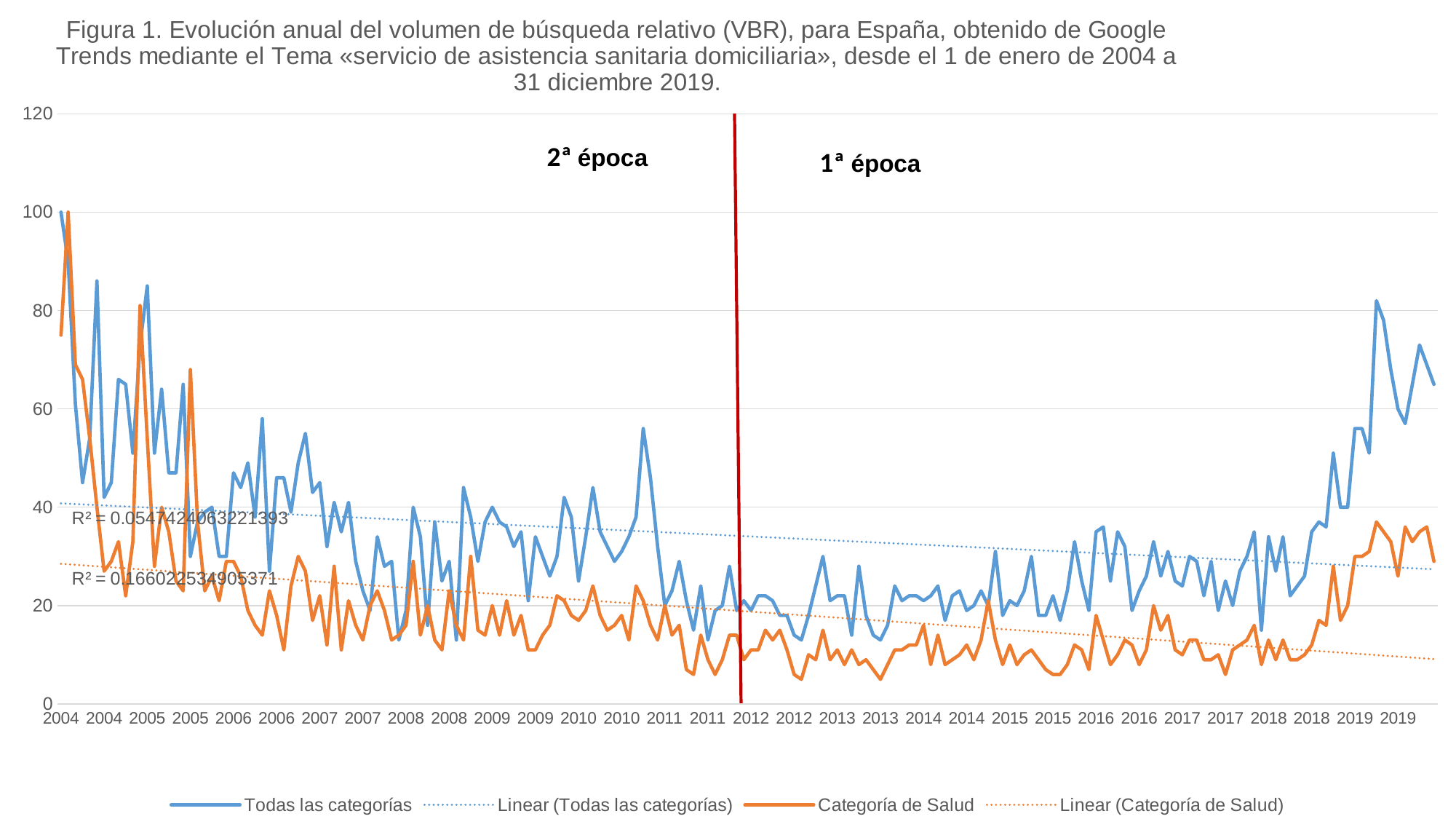
What kind of chart is shown on the slide? Line chart What is the first year shown on the x axis? 2004 Does the dotted linear trendline for 'Todas las categorías' rise or fall from 2004 to 2019? Fall What two periods does the red vertical line separate, according to the labels on the chart? 2ª época and 1ª época Which series is higher at the end of 2019, 'Todas las categorías' or 'Categoría de Salud'? Todas las categorías Does the dotted linear trendline for 'Categoría de Salud' rise or fall across the x axis? Fall Is the value for 'Categoría de Salud' at the start of 2013 greater or less than 40? less How many entries does the legend list? 4 What is the R² value shown for the 'Categoría de Salud' trendline? 0.166022534905371 What is the R² value shown for the 'Todas las categorías' trendline? 0.0547424063221393 Is the highest value for 'Todas las categorías' during 2019 greater or less than 60? greater Is the value for 'Categoría de Salud' at the end of 2019 greater or less than 60? less